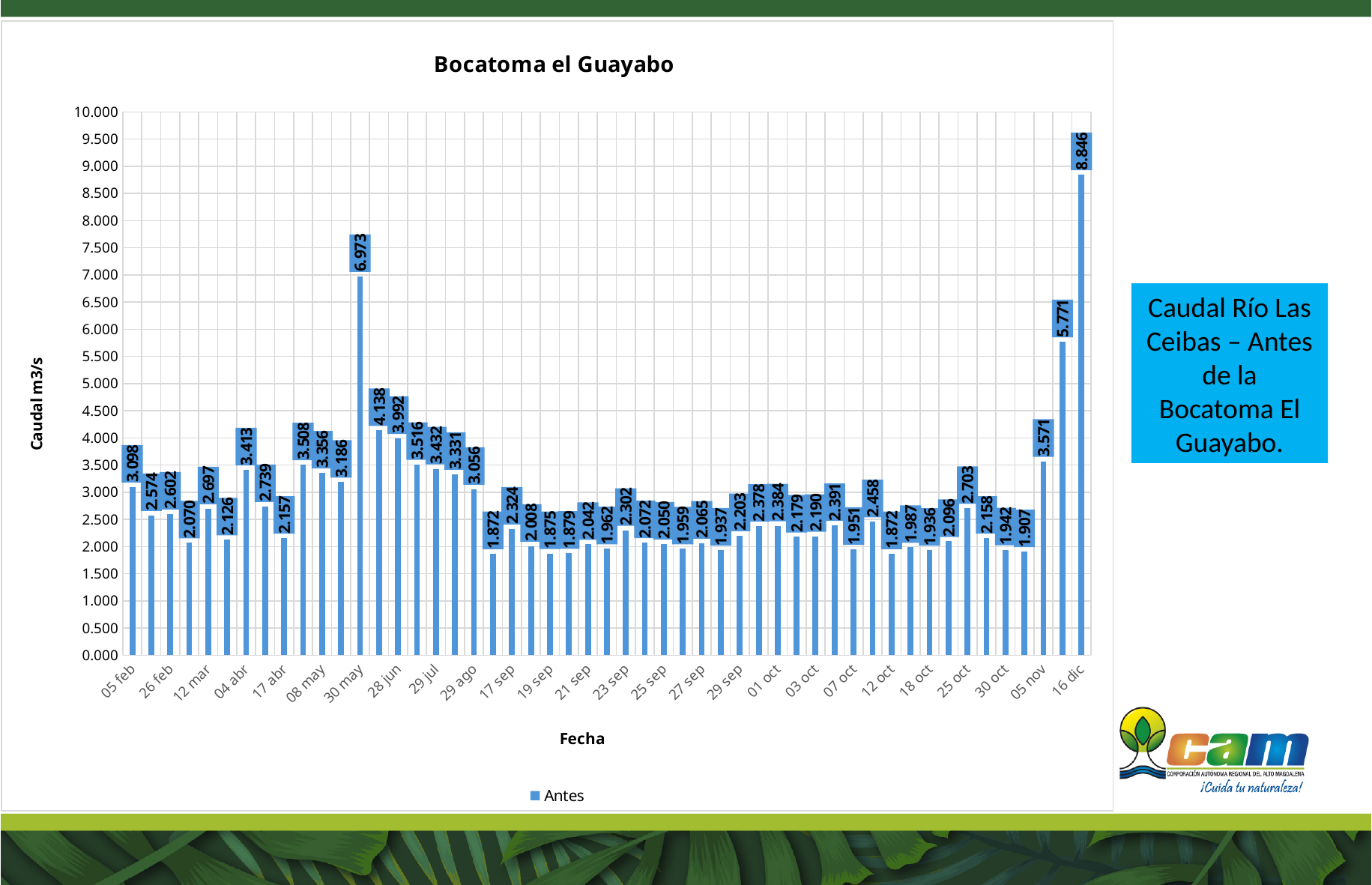
How many series does the legend list? 1 Which is larger, the value for 30 may or the value for 05 feb? 30 may What is the name of the series shown in the legend? Antes What is the difference between the value for 16 dic and the value for 30 may? 1.873 Which date has the highest value? 16 dic Is the value for 05 feb greater or less than 3.500? less What type of chart is shown on the slide? bar chart What is the value for 30 may? 6.973 What is the value for 16 dic? 8.846 Is the value for 16 dic greater or less than 8.000? greater What is the title of the chart? Bocatoma el Guayabo What is the value for 05 feb? 3.098